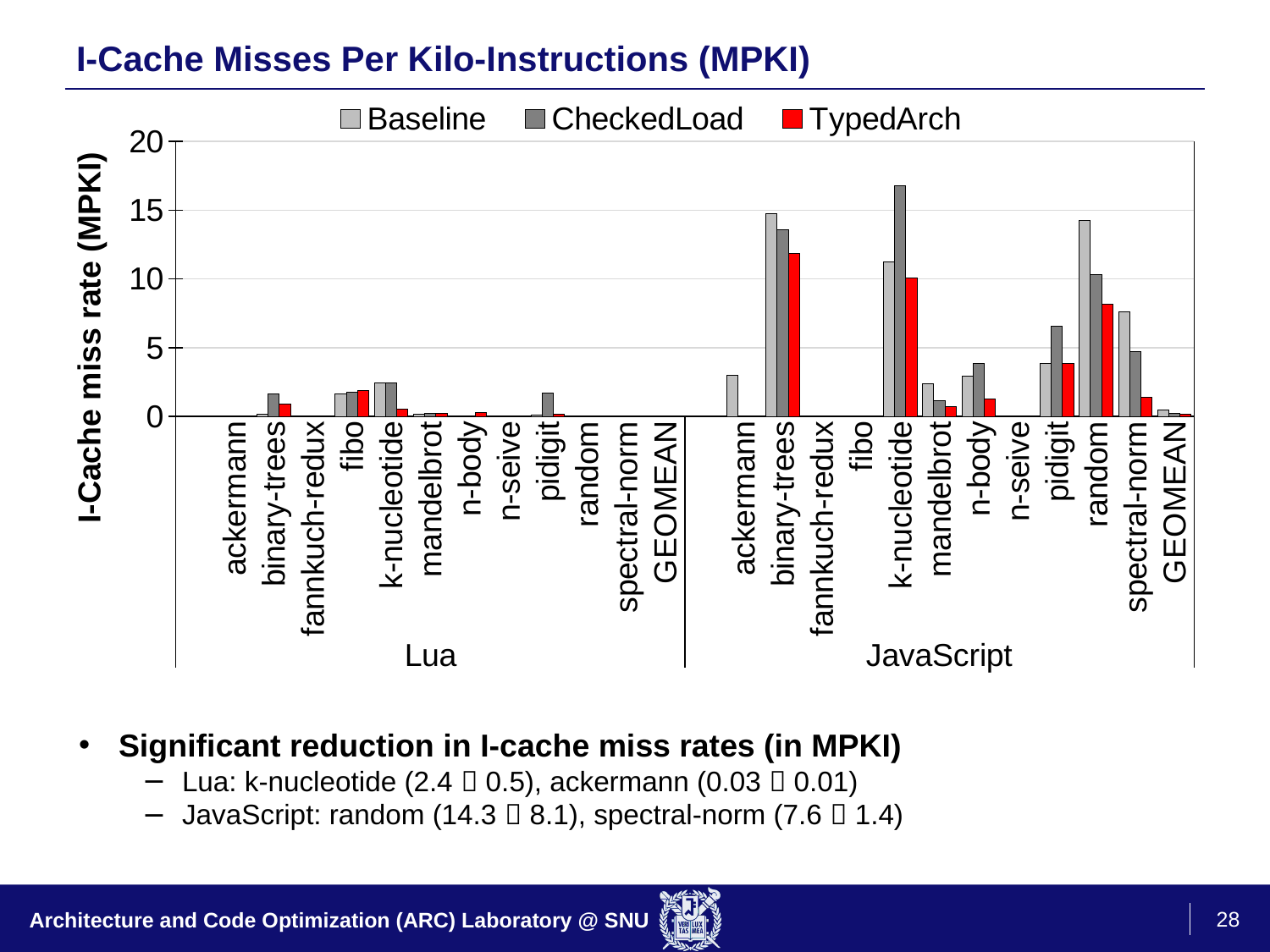
What is the label of the y axis? I-Cache miss rate (MPKI) How many series does the legend list? 3 Is the Baseline value for k-nucleotide in the Lua group greater or less than 5? less According to the slide text, what is the Baseline I-cache miss rate for random in JavaScript? 14.3 For random in the JavaScript group, which is larger, the Baseline value or the CheckedLoad value? Baseline How many benchmark categories are shown in the Lua group? 12 Which series is drawn in red in the legend? TypedArch Is the Baseline value for binary-trees in the JavaScript group greater or less than 10? greater What kind of chart is shown on the slide? bar chart Which benchmark has the highest CheckedLoad bar on the chart? k-nucleotide (JavaScript) Is the CheckedLoad value for k-nucleotide in the JavaScript group greater or less than 15? greater According to the slide text, what is the TypedArch I-cache miss rate for spectral-norm in JavaScript? 1.4